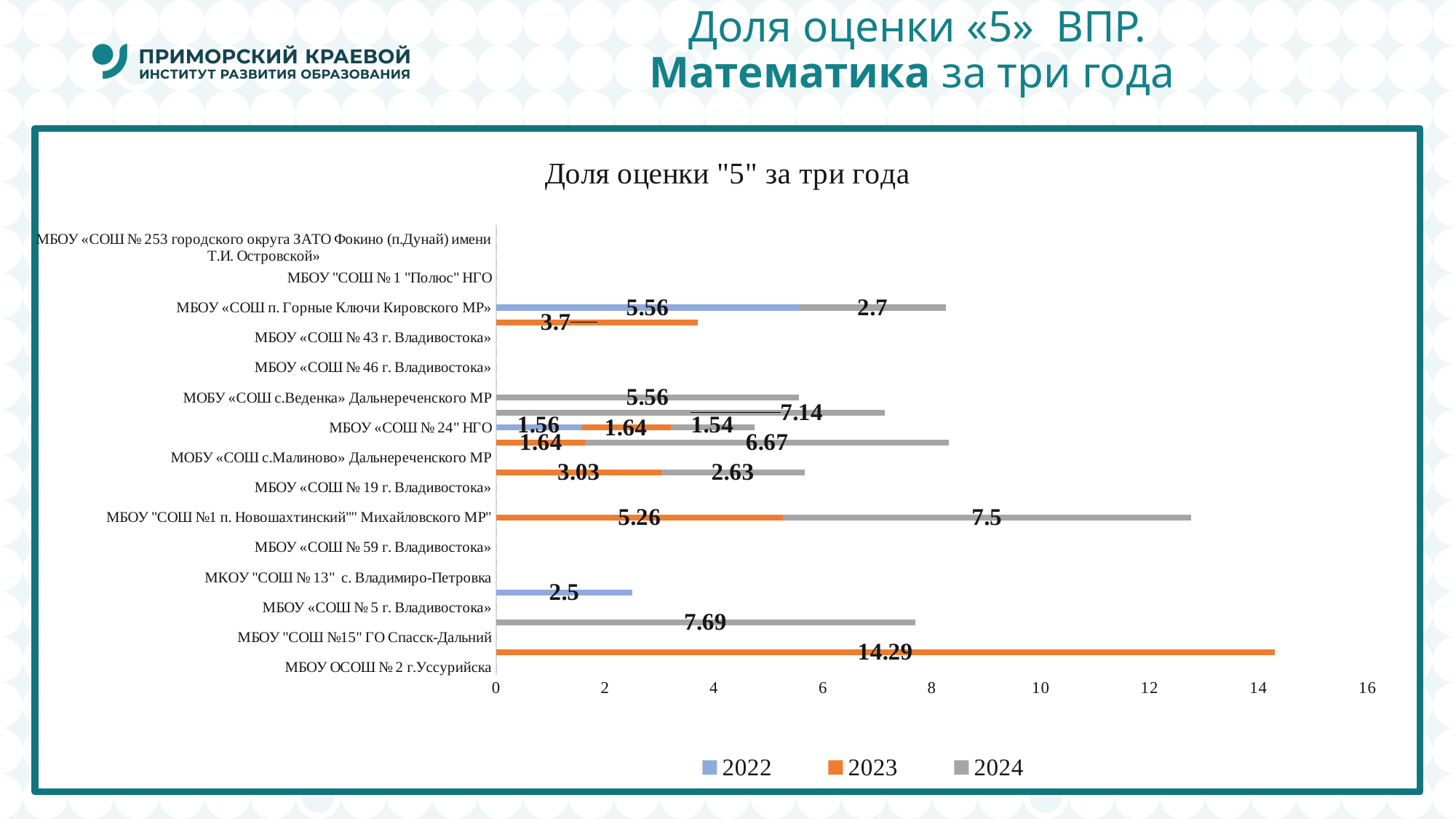
What is the title of the chart? Доля оценки "5" за три года How many series does the legend list? 3 What kind of chart is shown on the slide? bar chart What is the 2022 value for МБОУ «СОШ п. Горные Ключи Кировского МР»? 5.56 What is the 2023 value for МБОУ "СОШ №1 п. Новошахтинский" Михайловского МР? 5.26 Which years are listed in the legend? 2022, 2023, 2024